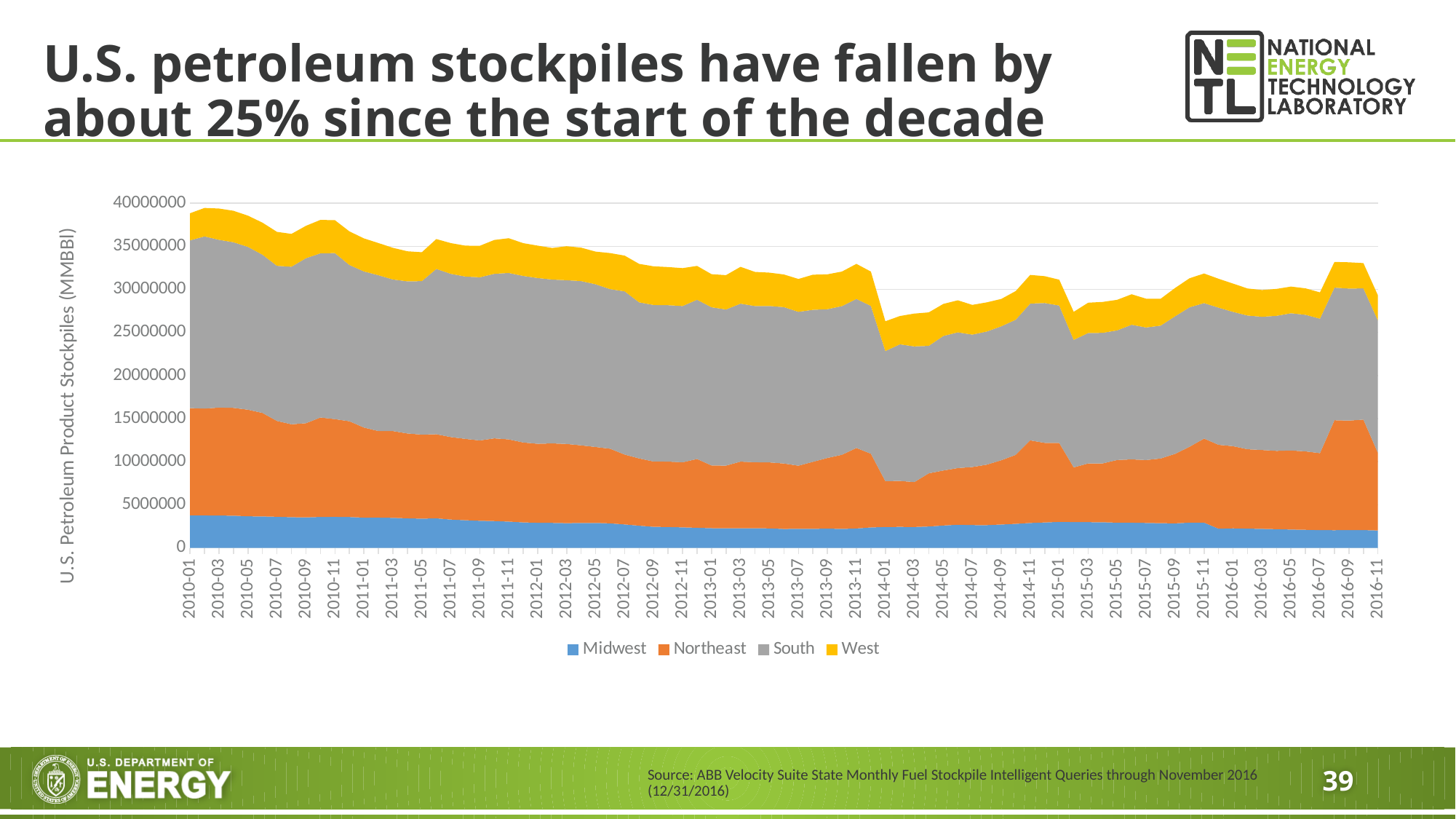
Is the Midwest value at 2010-01 greater or less than 5000000? less What kind of chart is shown on the slide? Stacked area chart Is the total stockpile value at 2010-01 greater or less than 35000000? greater At 2010-01, which is larger, the Northeast value or the Midwest value? Northeast Which series are listed in the legend? Midwest, Northeast, South, West How many series does the legend list? 4 Is the total stockpile value at 2014-01 greater or less than 25000000? greater What is the label of the vertical axis? U.S. Petroleum Product Stockpiles (MMBBl) Overall, do total U.S. petroleum product stockpiles rise or fall from 2010-01 to 2016-11? Fall Which region contributes the largest share of the stockpiles throughout the period? South